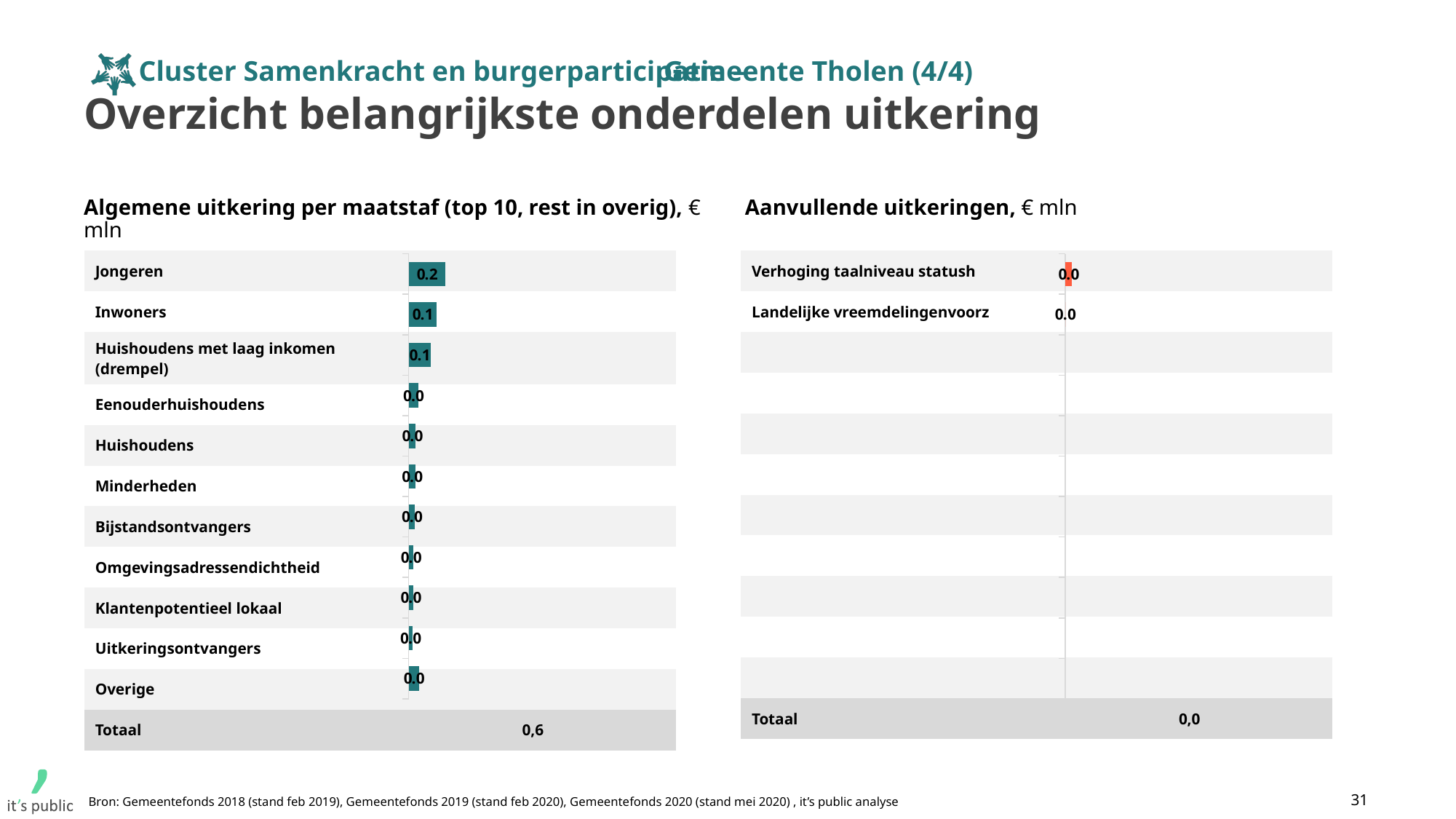
In the chart 'Algemene uitkering per maatstaf', what is the value for Inwoners? 0.1 What kind of chart is 'Algemene uitkering per maatstaf'? Bar chart In the chart 'Aanvullende uitkeringen', how many categories are shown (excluding the Totaal row)? 2 In the chart 'Algemene uitkering per maatstaf', what is the value for Jongeren? 0.2 In the chart 'Algemene uitkering per maatstaf', how many categories are shown (excluding the Totaal row)? 11 In the chart 'Algemene uitkering per maatstaf', what is the value for Huishoudens met laag inkomen (drempel)? 0.1 In the chart 'Algemene uitkering per maatstaf', which is larger, the value for Jongeren or the value for Inwoners? Jongeren In the chart 'Algemene uitkering per maatstaf', which category has the highest value? Jongeren In the chart 'Aanvullende uitkeringen', what is the Totaal value shown? 0,0 In the chart 'Algemene uitkering per maatstaf', what is the Totaal value shown? 0,6 In the chart 'Aanvullende uitkeringen', what is the value for Verhoging taalniveau statush? 0.0 In the chart 'Algemene uitkering per maatstaf', what is the difference between the value for Jongeren and the value for Inwoners? 0.1